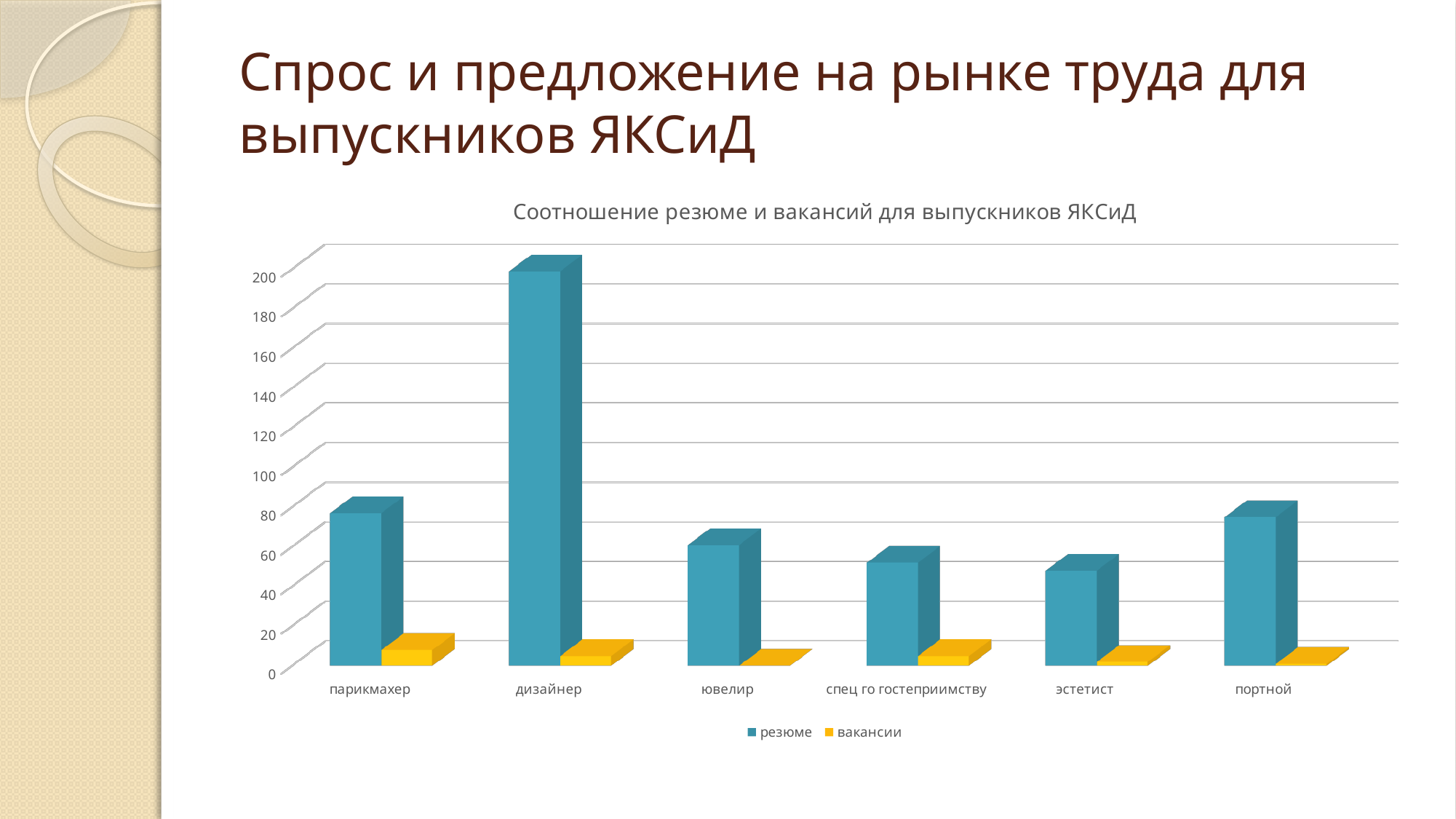
Is the резюме value for портной greater or less than 60? greater What is the title of the chart? Соотношение резюме и вакансий для выпускников ЯКСиД Is the резюме value for ювелир greater or less than 80? less Is the вакансии value for парикмахер greater or less than 40? less Which is larger for резюме: дизайнер or ювелир? дизайнер How many categories are shown on the x axis? 6 What kind of chart is shown on the slide? bar chart Which category has the highest value for резюме? дизайнер Which is larger for резюме: парикмахер or ювелир? парикмахер Which series is shown in yellow? вакансии How many series does the legend list? 2